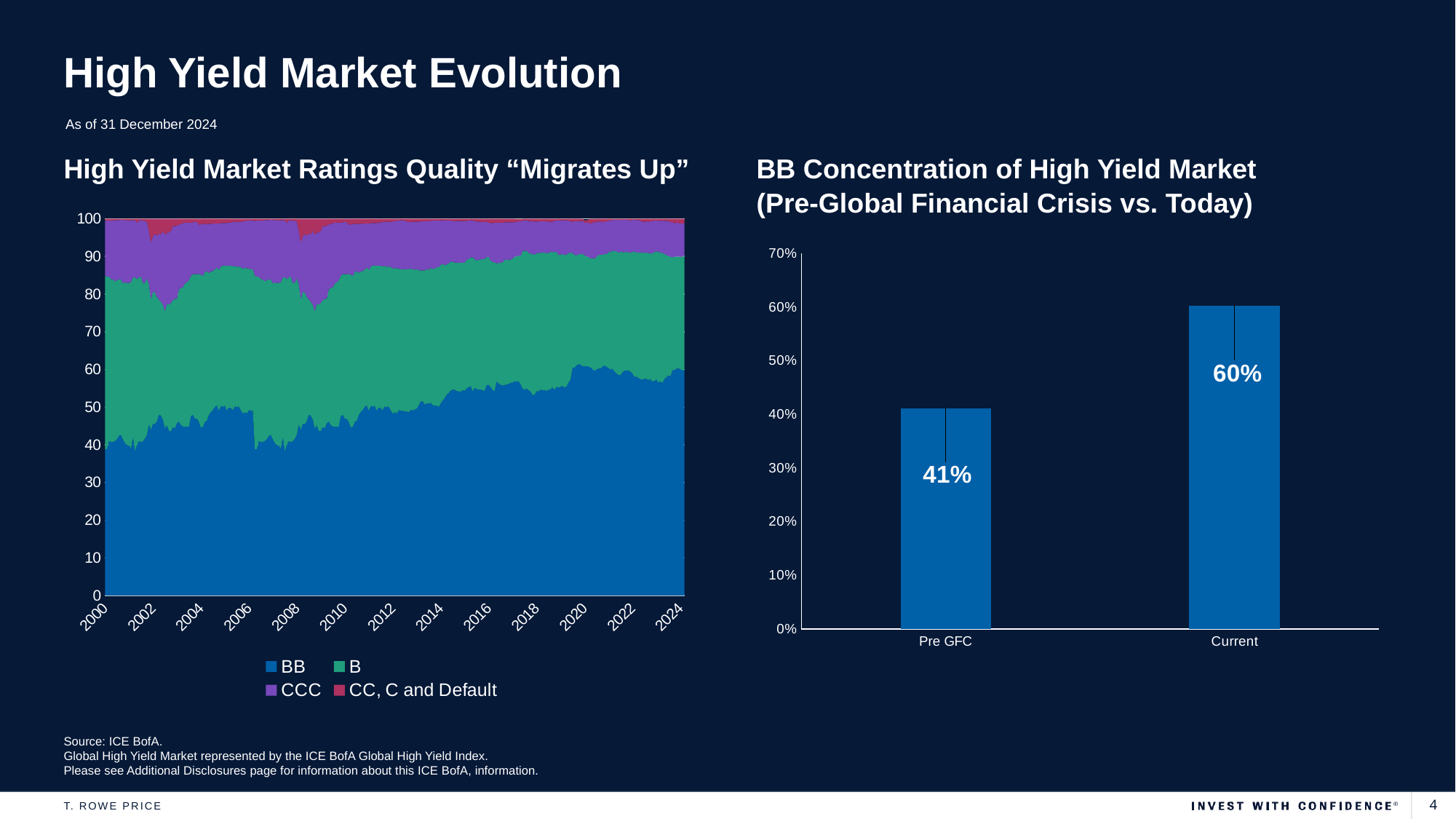
In the 'High Yield Market Ratings Quality' chart, does the BB share rise or fall from 2000 to 2024? rise How many series does the legend of the 'High Yield Market Ratings Quality' chart list? 4 In the 'BB Concentration of High Yield Market' chart, what is the difference between the Current and Pre GFC values? 19% In the 'High Yield Market Ratings Quality' chart, what is the first year shown on the x axis? 2000 In the 'BB Concentration of High Yield Market' chart, how many bars are shown? 2 In the 'BB Concentration of High Yield Market' chart, which category has the higher value? Current In the 'BB Concentration of High Yield Market' chart, is the value for Pre GFC greater or less than 50%? less In the 'High Yield Market Ratings Quality' chart, which series is shown in purple? CCC In the 'High Yield Market Ratings Quality' chart, is the BB share in 2024 greater or less than 50? greater What kind of chart is the 'BB Concentration of High Yield Market' chart? bar chart In the 'BB Concentration of High Yield Market' chart, what is the value for Pre GFC? 41% In the 'BB Concentration of High Yield Market' chart, what is the value for Current? 60%